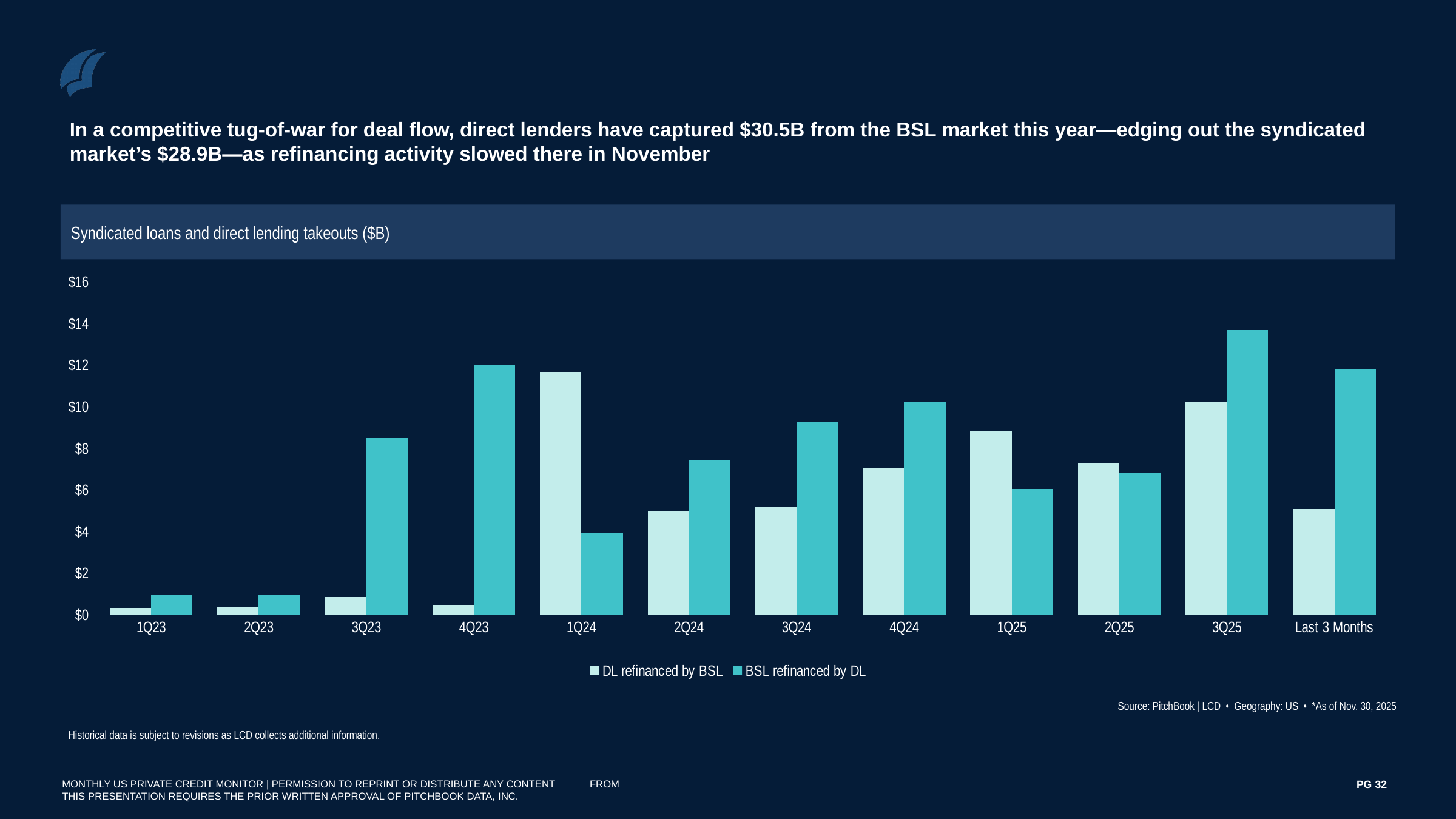
How many series does the legend list? 2 What is the title of the chart? Syndicated loans and direct lending takeouts ($B) How many categories are shown along the x axis? 12 Is the value for DL refinanced by BSL in 4Q23 greater or less than $2? less Is the value for BSL refinanced by DL in 1Q24 greater or less than $6? less In which period is the value for DL refinanced by BSL highest? 1Q24 Is the value for BSL refinanced by DL in 3Q25 greater or less than $12? greater In which period is the value for BSL refinanced by DL highest? 3Q25 What kind of chart is shown on the slide? Bar chart In 4Q23, which is larger: DL refinanced by BSL or BSL refinanced by DL? BSL refinanced by DL In 1Q25, which is larger: DL refinanced by BSL or BSL refinanced by DL? DL refinanced by BSL